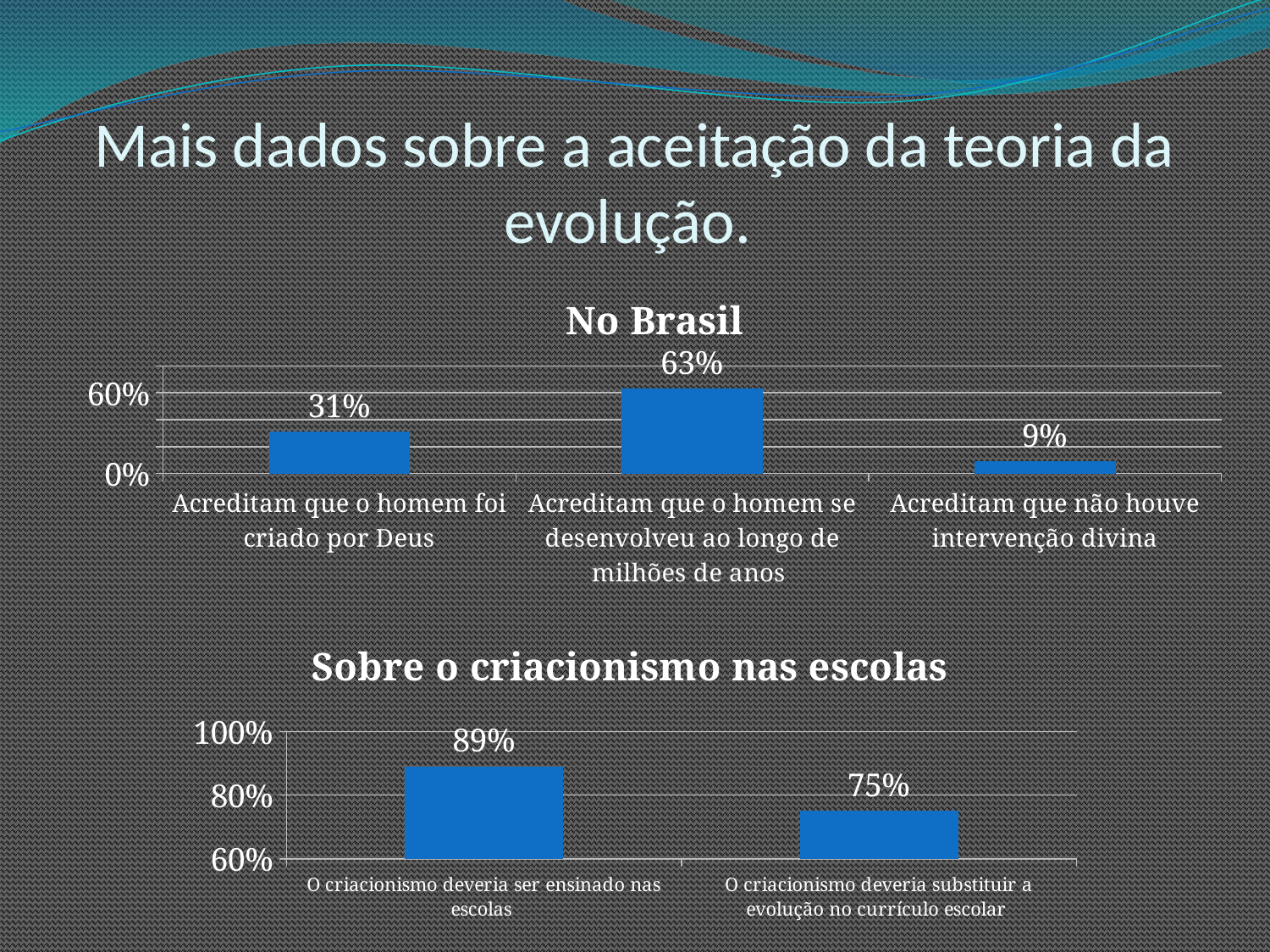
In the 'No Brasil' chart, what is the value for 'Acreditam que o homem se desenvolveu ao longo de milhões de anos'? 63% In the 'Sobre o criacionismo nas escolas' chart, what is the value for 'O criacionismo deveria substituir a evolução no currículo escolar'? 75% In the 'No Brasil' chart, what is the value for 'Acreditam que o homem foi criado por Deus'? 31% In the 'No Brasil' chart, how many categories are shown? 3 In the 'No Brasil' chart, what is the difference between the values for 'Acreditam que o homem se desenvolveu ao longo de milhões de anos' and 'Acreditam que o homem foi criado por Deus'? 32% What kind of chart is the 'Sobre o criacionismo nas escolas' chart? Bar chart In the 'No Brasil' chart, which category has the lowest value? Acreditam que não houve intervenção divina In the 'No Brasil' chart, which category has the highest value? Acreditam que o homem se desenvolveu ao longo de milhões de anos In the 'Sobre o criacionismo nas escolas' chart, what is the difference between the two values shown? 14% In the 'Sobre o criacionismo nas escolas' chart, which is larger: the value for 'O criacionismo deveria ser ensinado nas escolas' or 'O criacionismo deveria substituir a evolução no currículo escolar'? O criacionismo deveria ser ensinado nas escolas In the 'No Brasil' chart, what is the value for 'Acreditam que não houve intervenção divina'? 9% In the 'Sobre o criacionismo nas escolas' chart, what is the value for 'O criacionismo deveria ser ensinado nas escolas'? 89%